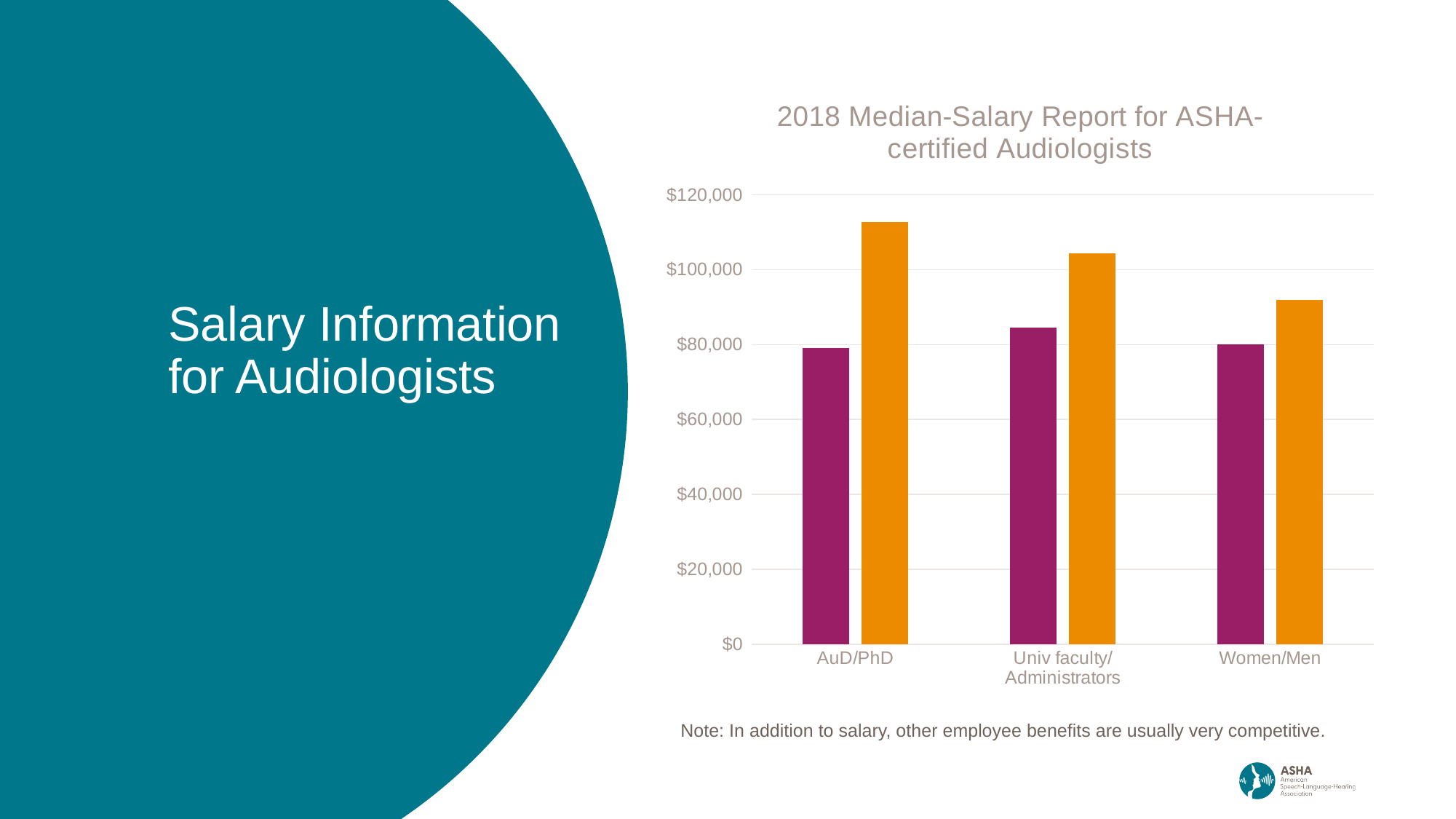
Is the magenta bar for AuD/PhD greater or less than $100,000? less How many categories are shown on the x axis of the chart? 3 How many bars are plotted in the chart in total? 6 Is the orange bar for Women/Men greater or less than $100,000? less What is the title of the chart? 2018 Median-Salary Report for ASHA-certified Audiologists In the Women/Men category, which bar is taller, the magenta bar or the orange bar? the orange bar Is the magenta bar for Women/Men greater or less than $60,000? greater Do the orange bars rise or fall moving from left to right across the categories? fall What kind of chart is shown on the slide? bar chart Which category has the tallest orange bar? AuD/PhD